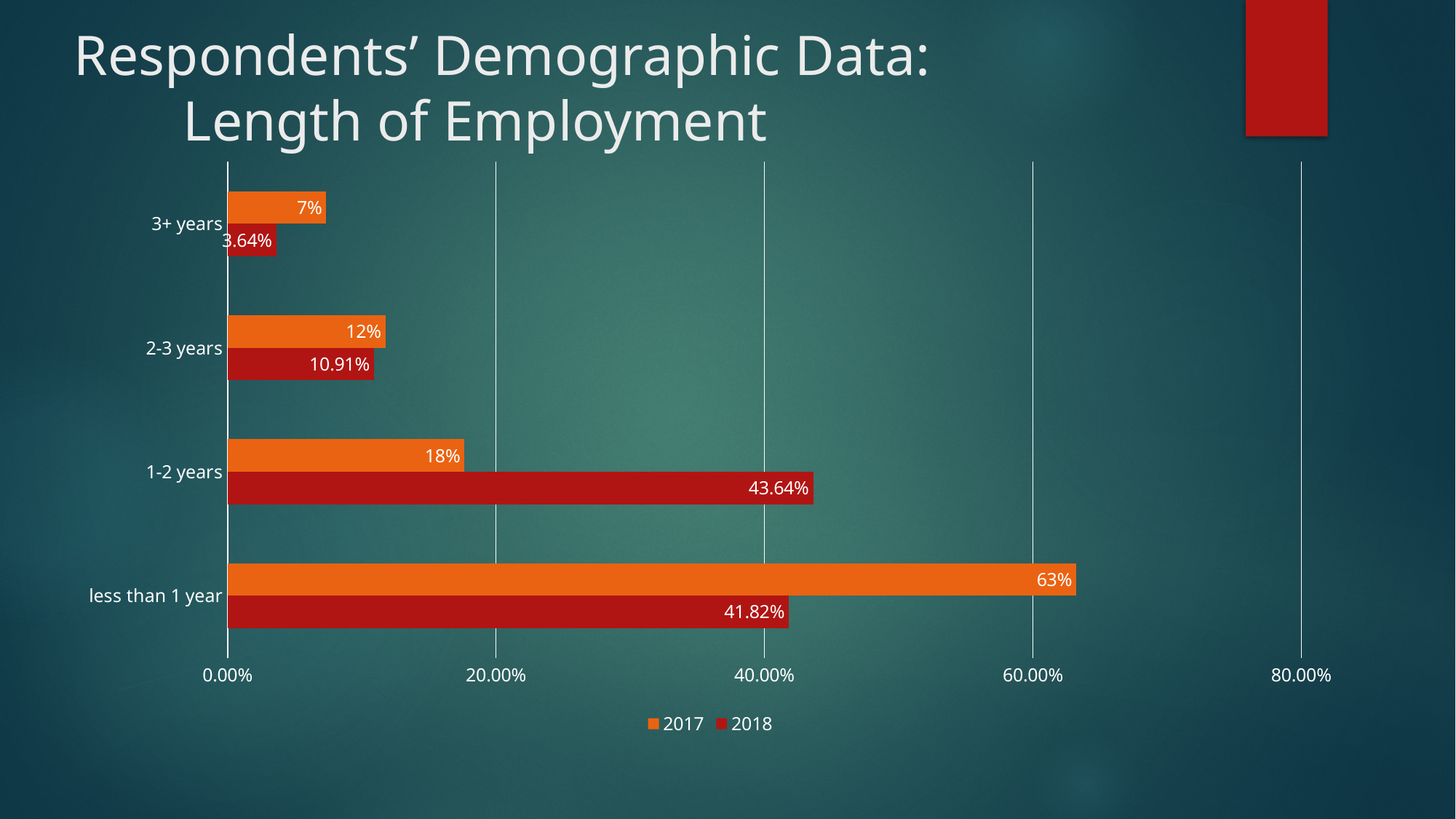
Which is larger for '1-2 years': the 2017 value or the 2018 value? 2018 How many categories are shown on the chart? 4 How many series does the legend list? 2 What kind of chart is shown on the slide? Bar chart What is the 2017 value for '2-3 years'? 12% What is the 2018 value for '3+ years'? 3.64% What is the 2017 value for 'less than 1 year'? 63% Which category has the highest 2018 value? 1-2 years Is the 2017 value for 'less than 1 year' greater or less than 60.00%? greater What is the 2018 value for '1-2 years'? 43.64% What is the difference between the 2018 values for '1-2 years' and 'less than 1 year'? 1.82% Which category has the lowest 2017 value? 3+ years